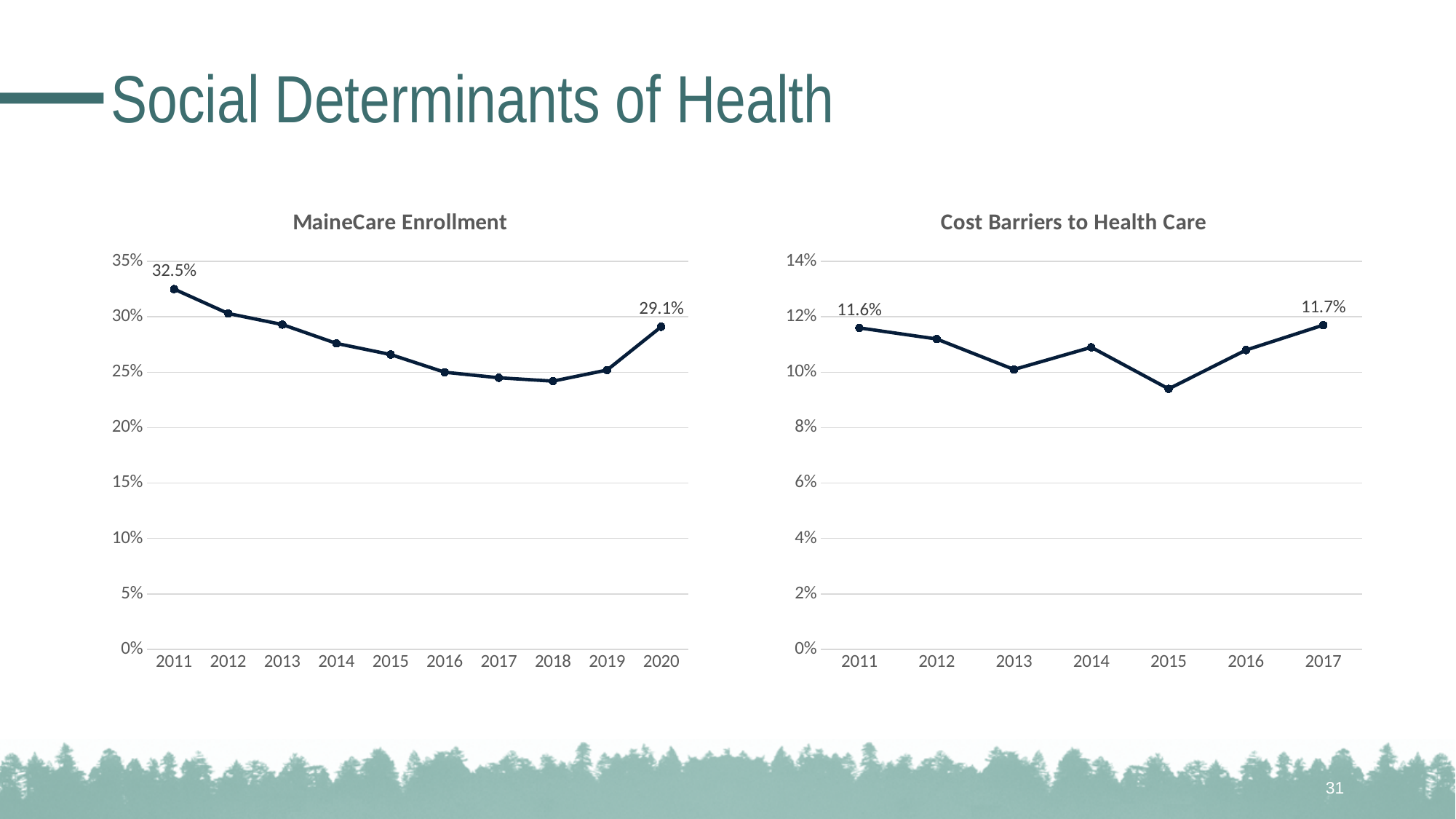
How many years are plotted in the MaineCare Enrollment chart? 10 In the MaineCare Enrollment chart, is the value for 2018 greater or less than 25%? less In the Cost Barriers to Health Care chart, what is the value for 2017? 11.7% In the MaineCare Enrollment chart, what is the difference between the 2011 and 2020 values? 3.4% In the MaineCare Enrollment chart, what is the value for 2011? 32.5% In the MaineCare Enrollment chart, which year has the highest value? 2011 In the Cost Barriers to Health Care chart, which year has the lowest value? 2015 How many years are plotted in the Cost Barriers to Health Care chart? 7 In the MaineCare Enrollment chart, what is the value for 2020? 29.1% In the Cost Barriers to Health Care chart, what is the value for 2011? 11.6% What kind of chart is the MaineCare Enrollment chart? Line chart In the Cost Barriers to Health Care chart, is the value for 2015 greater or less than 10%? less